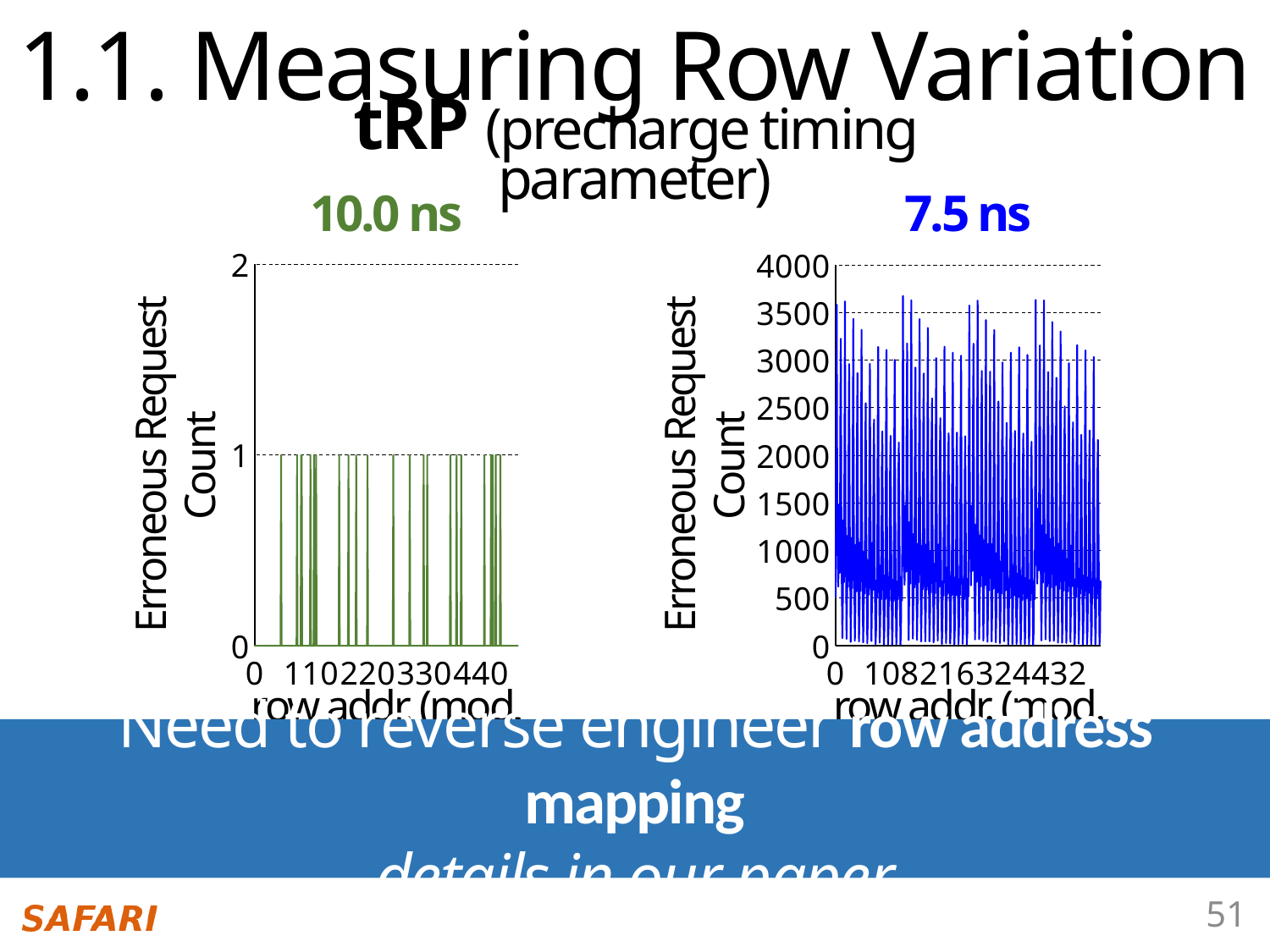
In the 7.5 ns chart, is the highest erroneous request count greater or less than 4000? less In the 7.5 ns chart, is the highest erroneous request count greater or less than 3000? greater Which chart shows higher erroneous request counts, the 10.0 ns chart or the 7.5 ns chart? 7.5 ns What is the highest value on the y-axis of the 7.5 ns chart? 4000 What is the last x-axis tick label on the 10.0 ns chart? 440 In the 10.0 ns chart, what is the highest erroneous request count reached by any row? 1 What is the y-axis label on the 7.5 ns chart? Erroneous Request Count What kind of chart is the 10.0 ns chart? line chart In the 10.0 ns chart, is the highest erroneous request count greater or less than 2? less How many charts are shown on the slide? 2